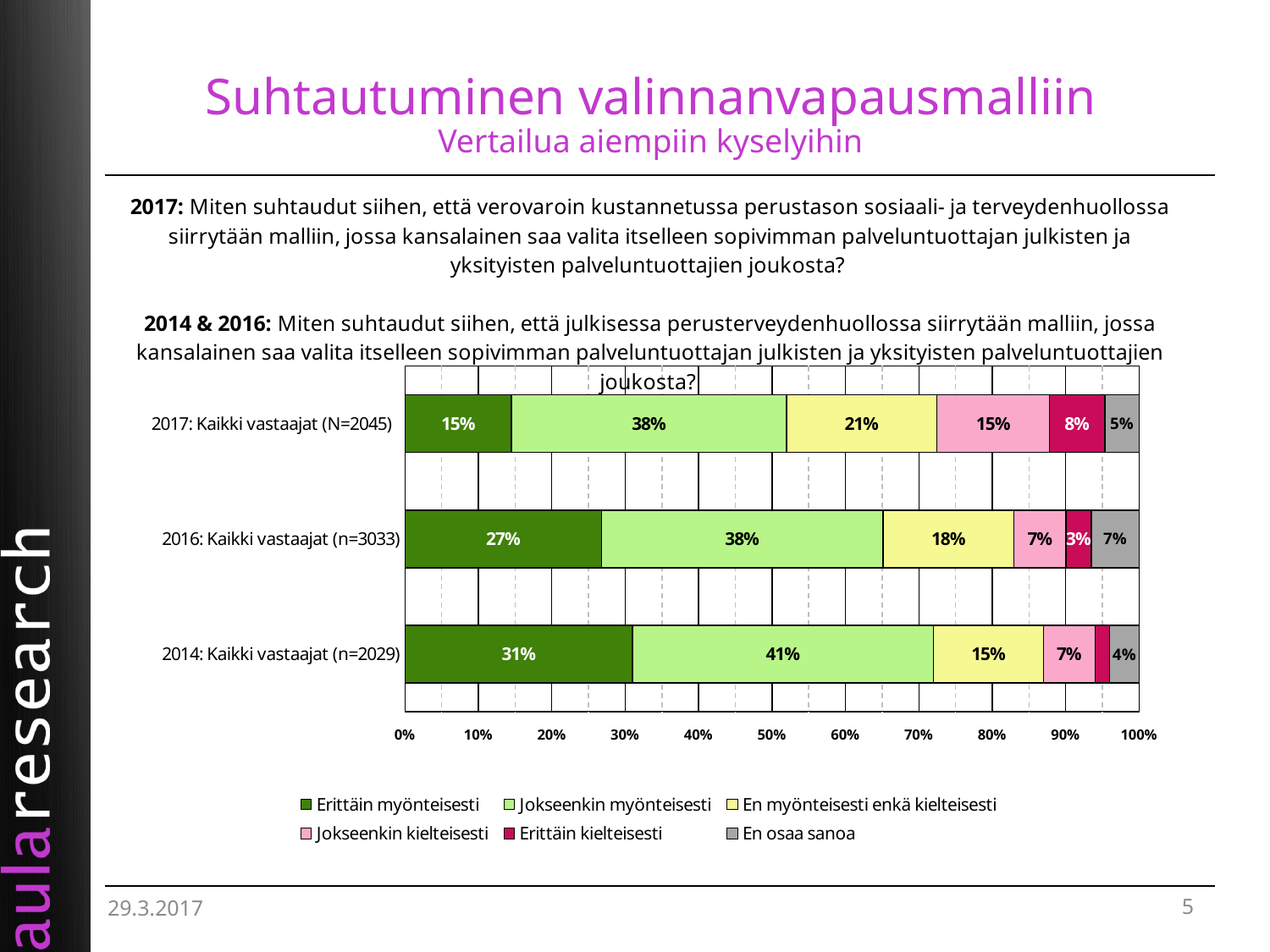
How many response categories does the legend list? 6 Which survey year has the lowest "Erittäin myönteisesti" share? 2017: Kaikki vastaajat (N=2045) What is the "En myönteisesti enkä kielteisesti" value for 2016 (n=3033)? 18% What is the "Erittäin kielteisesti" share for 2017 (N=2045)? 8% What is the "Jokseenkin myönteisesti" share for 2014 (n=2029)? 41% How many survey years (bars) are shown in the chart? 3 What is the "En osaa sanoa" share for 2016 (n=3033)? 7% What percentage of respondents in 2017 (N=2045) answered "Erittäin myönteisesti"? 15% What type of chart is shown on the slide? Stacked bar chart Which survey year has the highest "Erittäin myönteisesti" share? 2014: Kaikki vastaajat (n=2029) What is the difference between the "Erittäin myönteisesti" shares of 2014 (n=2029) and 2017 (N=2045)? 16 percentage points Which is larger: the "Jokseenkin kielteisesti" share in 2017 (N=2045) or in 2016 (n=3033)? 2017 (N=2045)